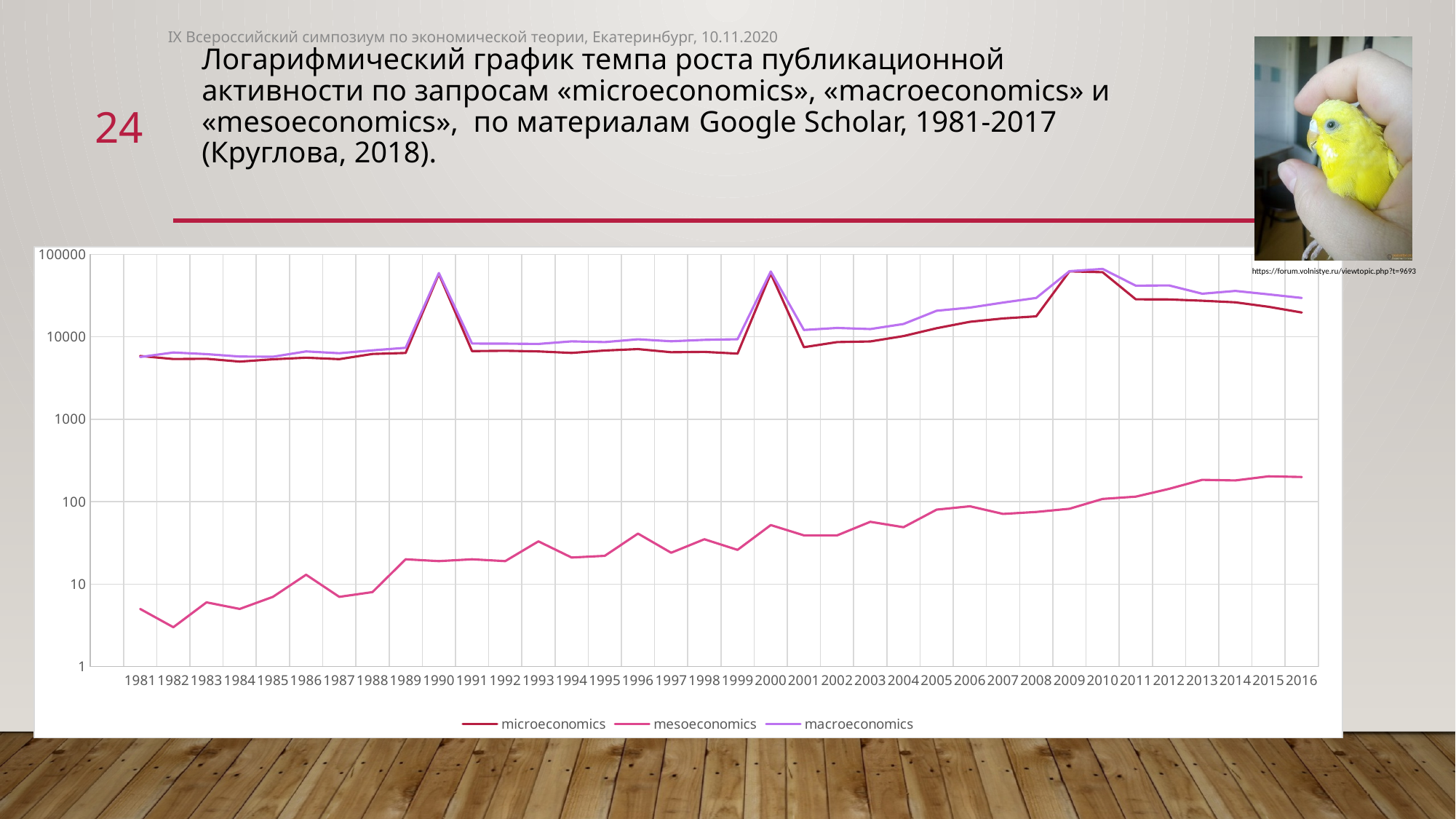
Which series has the lowest values across all years? mesoeconomics What is the first year shown on the x axis? 1981 Is the value for macroeconomics in 2010 greater or less than 10000? greater Which is larger in 2016, the value for macroeconomics or the value for mesoeconomics? macroeconomics How many years are plotted along the x axis? 36 Is the value for microeconomics in 1981 greater or less than 10000? less Do the values for mesoeconomics generally rise or fall from 1981 to 2016? rise What kind of chart is shown on the slide? line chart Is the value for mesoeconomics in 2016 greater or less than 100? greater Which series is listed first in the legend? microeconomics How many series does the legend list? 3